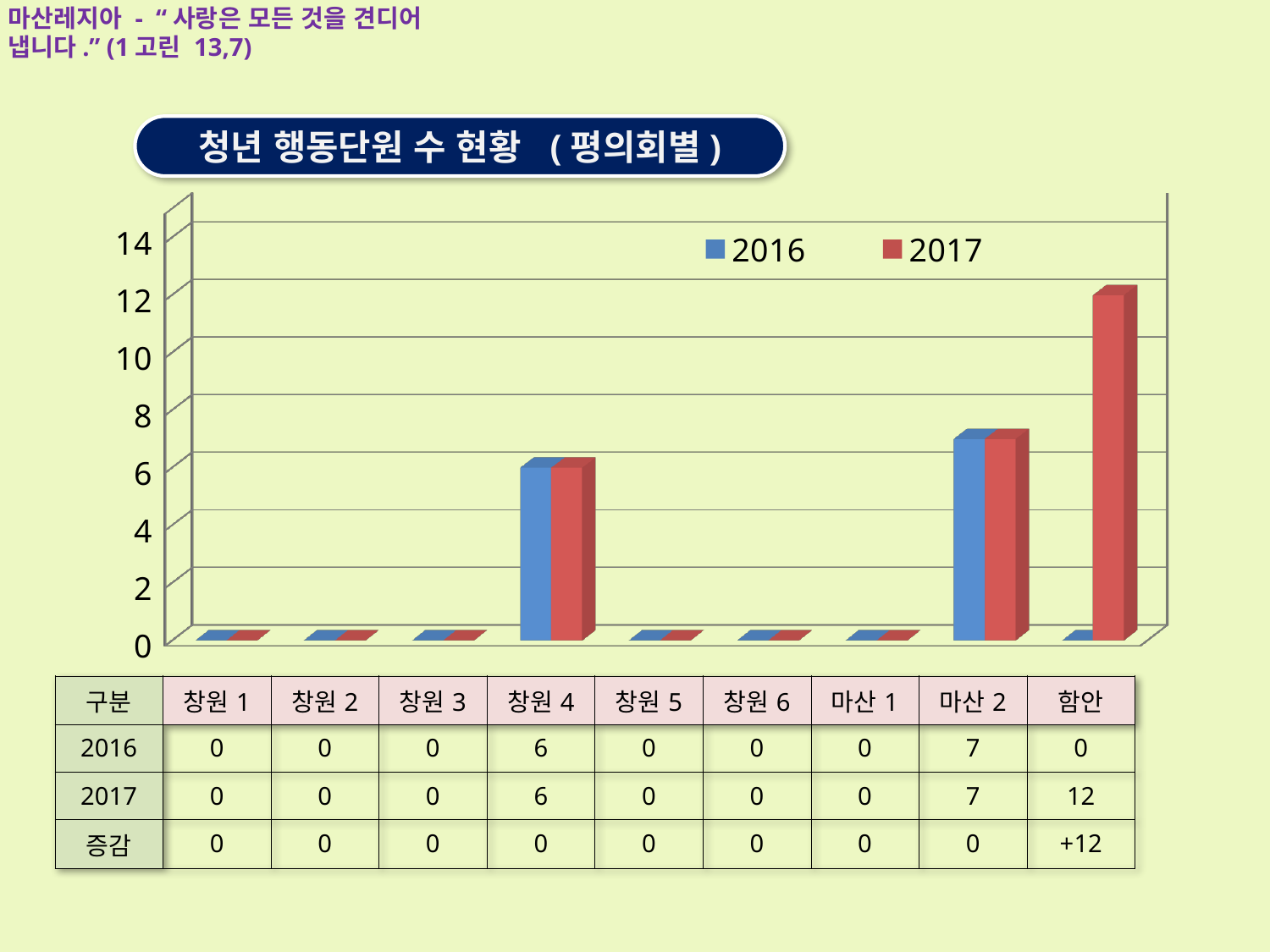
Which category has the highest 2017 value? 함안 What is the 2017 value for 창원 4? 6 How many series does the chart legend list? 2 What is the difference between the 2017 and 2016 values for 함안? 12 Which category has the highest 2016 value? 마산 2 Is the 2017 value for 함안 greater or less than 10? greater What is the 2017 value for 함안? 12 Which is larger, the 2017 value for 마산 2 or the 2017 value for 창원 4? 마산 2 What is the 2016 value for 함안? 0 What type of chart is shown on the slide? bar chart How many categories are shown on the x axis of the chart? 9 What is the 2016 value for 마산 2? 7